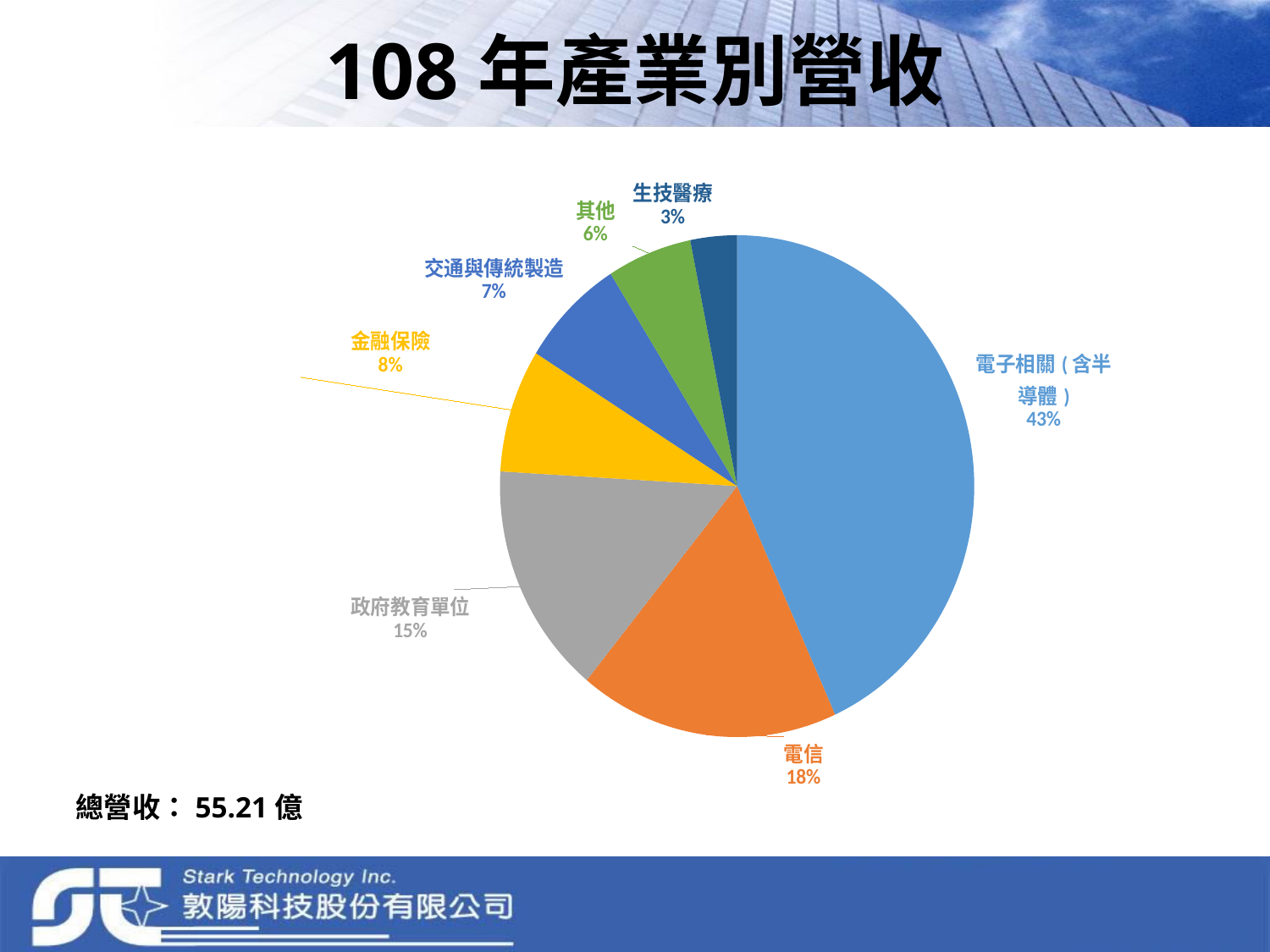
Which category has the smallest share of the pie? 生技醫療 What is the value for 金融保險? 8% What is the value for 交通與傳統製造? 7% What is the difference between the shares of 電信 and 政府教育單位? 3% What kind of chart is shown on the slide? pie chart Which category has the largest share of the pie? 電子相關（含半導體） What share of revenue does 電子相關（含半導體）account for? 43% What is the title of the chart? 108 年產業別營收 What is the value for 政府教育單位? 15% Which is larger, the share for 其他 or the share for 生技醫療? 其他 What is the value for 電信? 18% How many categories are shown in the pie chart? 7